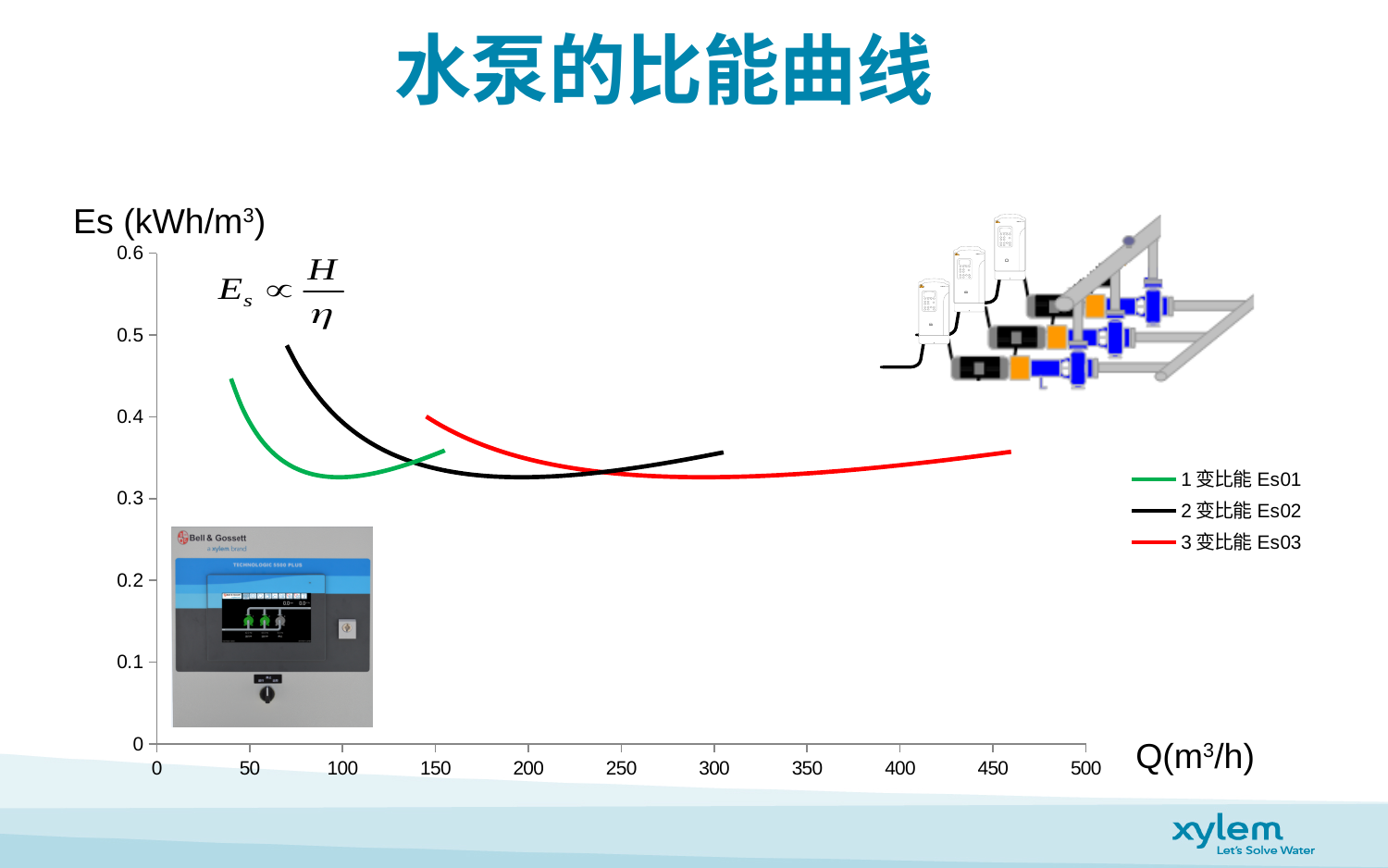
What kind of chart is shown on the slide? line chart Which series is drawn in red? 3 变比能 Es03 How many series does the legend list? 3 Is the value of the 3 变比能 Es03 curve at Q = 300 m³/h greater or less than 0.4? less Does the 3 变比能 Es03 curve rise or fall as Q increases from 300 to 450 m³/h? rise Which curve extends to the highest flow rate Q on the x axis? 3 变比能 Es03 Is the value of the 1 变比能 Es01 curve at Q = 100 m³/h greater or less than 0.4? less Is the value of the 2 变比能 Es02 curve at Q = 70 m³/h greater or less than 0.4? greater What is the label of the vertical axis? Es (kWh/m³) Which curve begins at the lowest flow rate Q on the x axis? 1 变比能 Es01 Does the 2 变比能 Es02 curve rise or fall as Q increases from 70 to 200 m³/h? fall